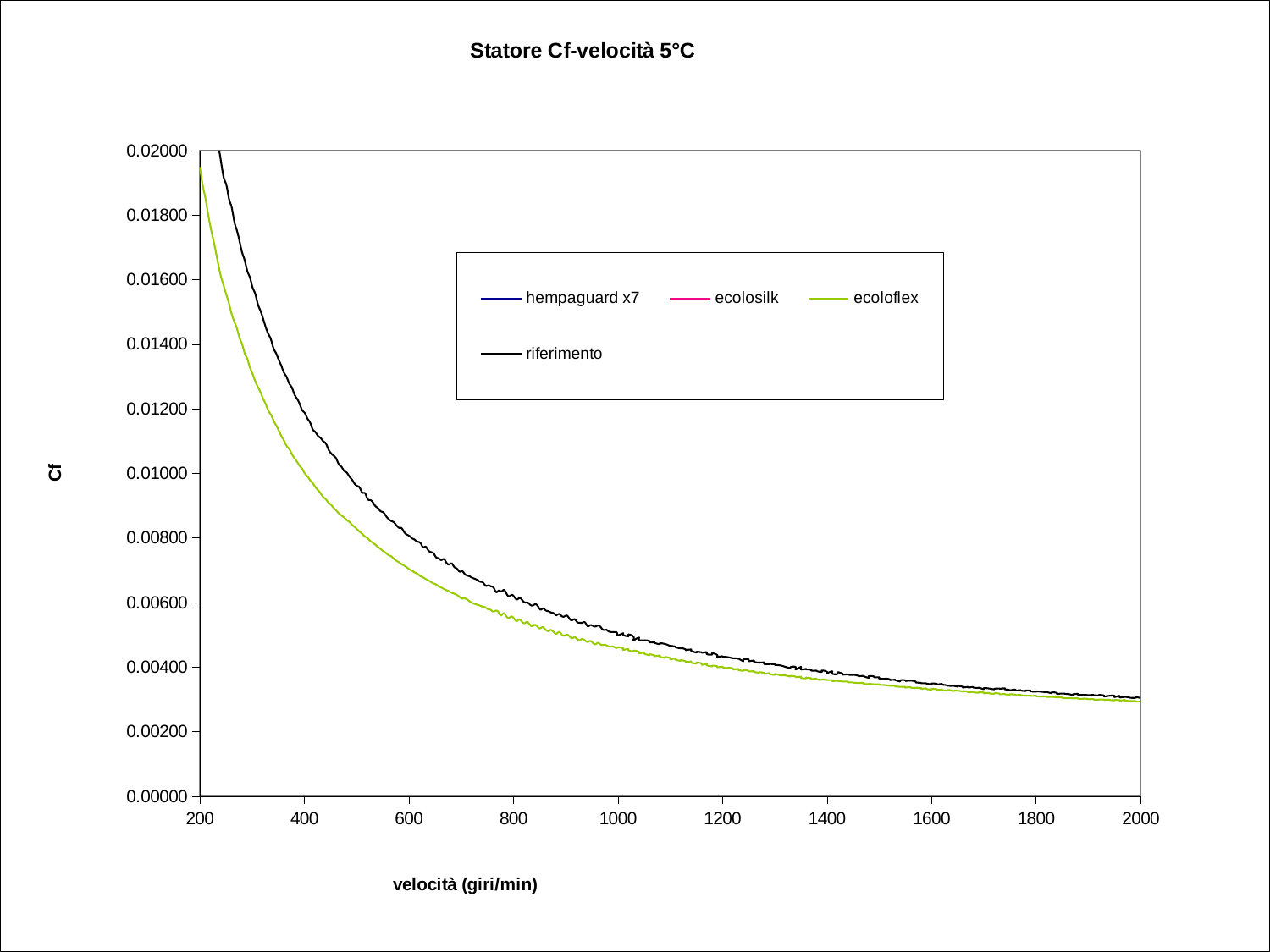
How many series does the legend list? 4 At 800 giri/min, which series has the higher Cf value, riferimento or ecoloflex? riferimento Is the riferimento value at 400 giri/min greater or less than 0.01000? greater Do the Cf values rise or fall as velocità increases along the x axis? fall Is the ecoloflex value at 1000 giri/min greater or less than 0.00400? greater What is the title of the chart? Statore Cf-velocità 5°C Is the ecoloflex value at 600 giri/min greater or less than 0.00600? greater What is the label of the x axis? velocità (giri/min) What kind of chart is shown on the slide? line chart